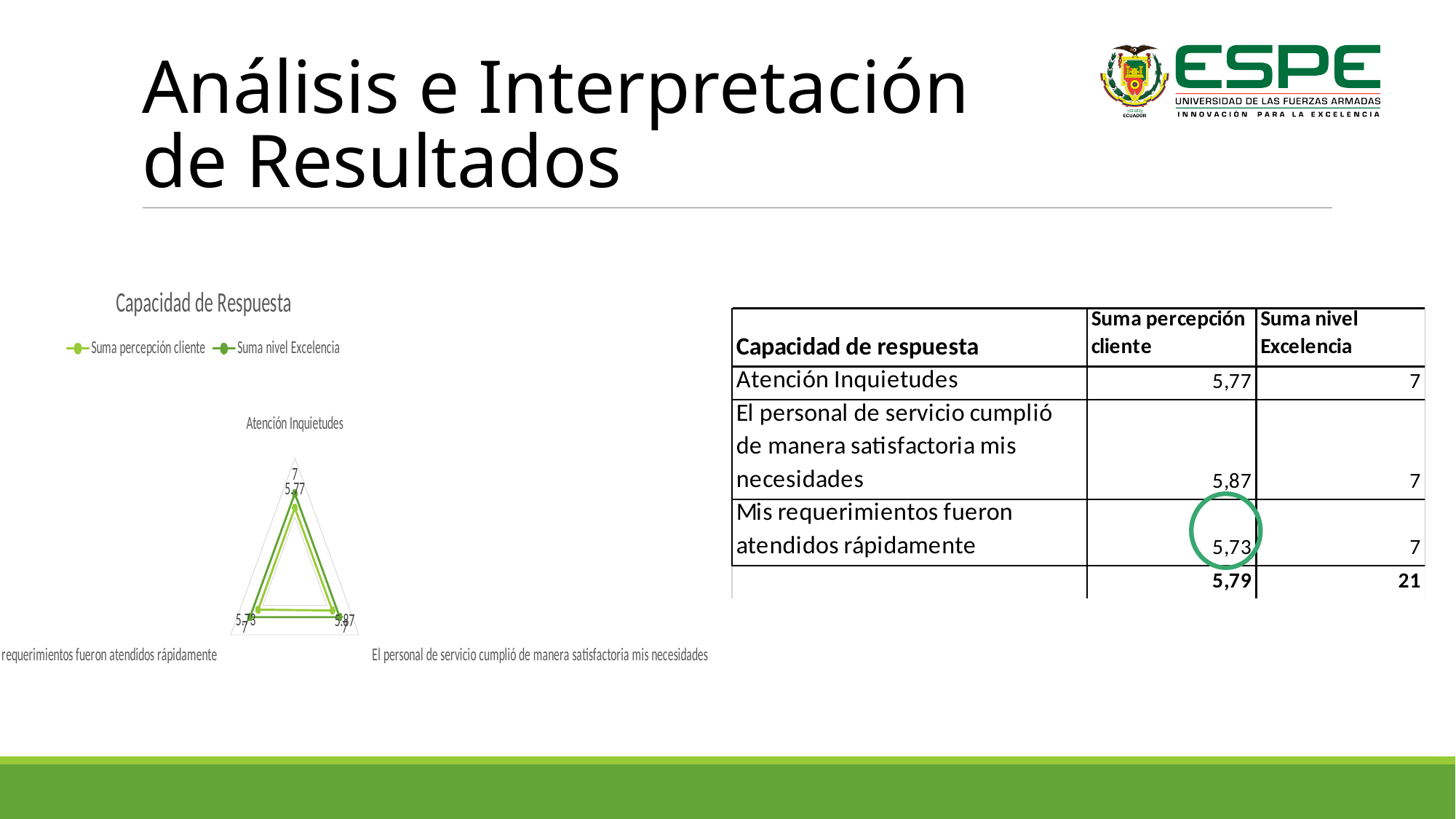
What is the value of Suma percepción cliente for Atención Inquietudes? 5,77 What is the value of Suma percepción cliente for 'Mis requerimientos fueron atendidos rápidamente'? 5,73 Which category has the highest Suma percepción cliente value? El personal de servicio cumplió de manera satisfactoria mis necesidades Which series has the larger value for Atención Inquietudes, Suma percepción cliente or Suma nivel Excelencia? Suma nivel Excelencia What kind of chart is shown on the slide? Radar chart What is the value of Suma nivel Excelencia for Atención Inquietudes? 7 What is the difference between Suma nivel Excelencia and Suma percepción cliente for Atención Inquietudes? 1,23 What is the value of Suma percepción cliente for 'El personal de servicio cumplió de manera satisfactoria mis necesidades'? 5,87 How many series does the chart's legend list? 2 How many categories (axes) does the radar chart have? 3 What is the title of the chart on the slide? Capacidad de Respuesta Which category has the lowest Suma percepción cliente value? Mis requerimientos fueron atendidos rápidamente